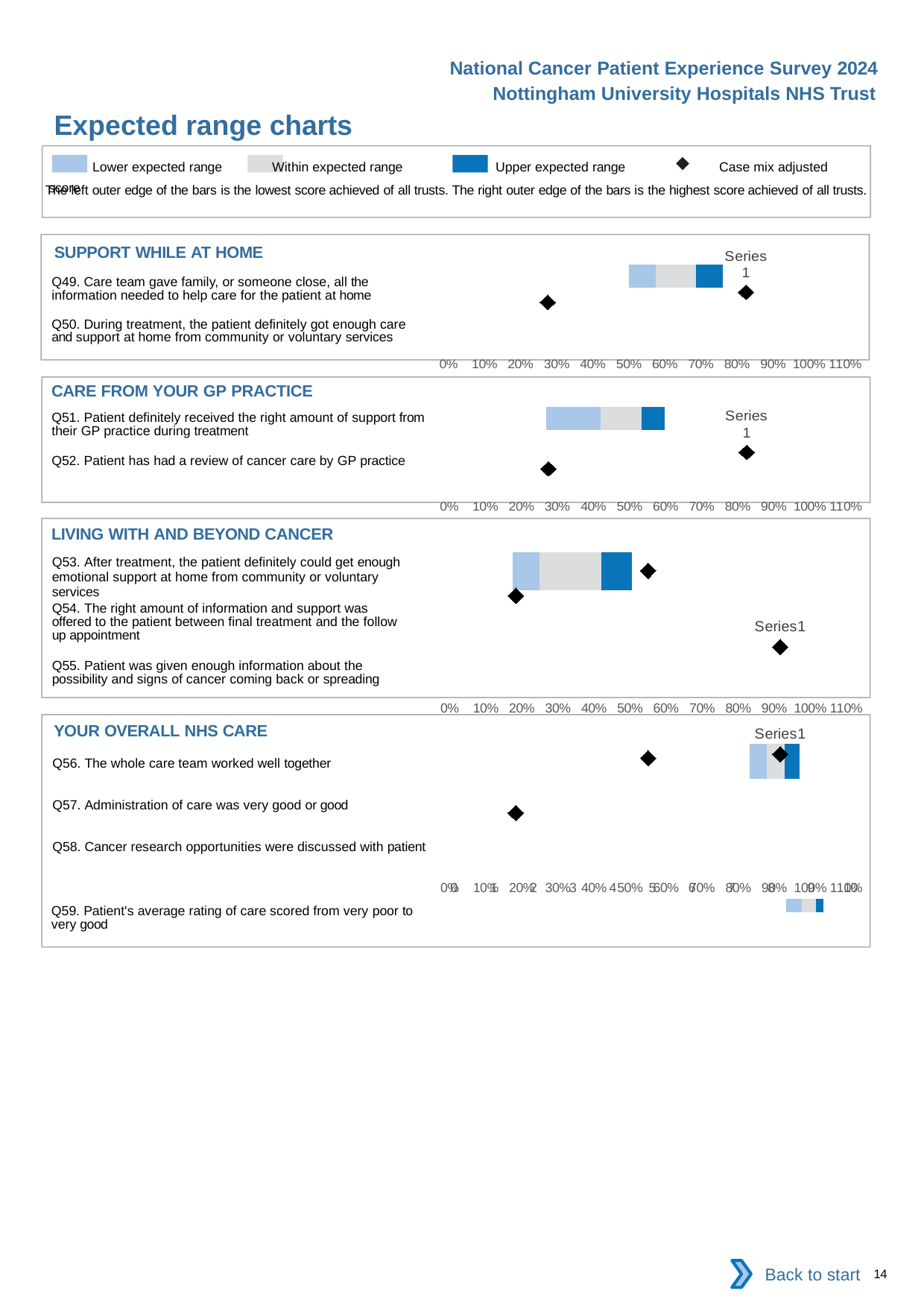
What is the highest tick label shown on the x axis of the CARE FROM YOUR GP PRACTICE chart? 110% Which legend entry is represented by a black diamond marker? Case mix adjusted score How many questions are listed in the YOUR OVERALL NHS CARE section? 4 In the CARE FROM YOUR GP PRACTICE chart, is the right edge of the expected range bar greater or less than 70%? less How many questions are listed in the LIVING WITH AND BEYOND CANCER section? 3 In the SUPPORT WHILE AT HOME chart, is the left edge of the expected range bar greater or less than 40%? greater How many entries does the legend at the top of the slide list? 4 In the LIVING WITH AND BEYOND CANCER chart, is the left edge of the expected range bar greater or less than 30%? less What kind of chart is used in the SUPPORT WHILE AT HOME section? bar chart How many questions are listed in the SUPPORT WHILE AT HOME section? 2